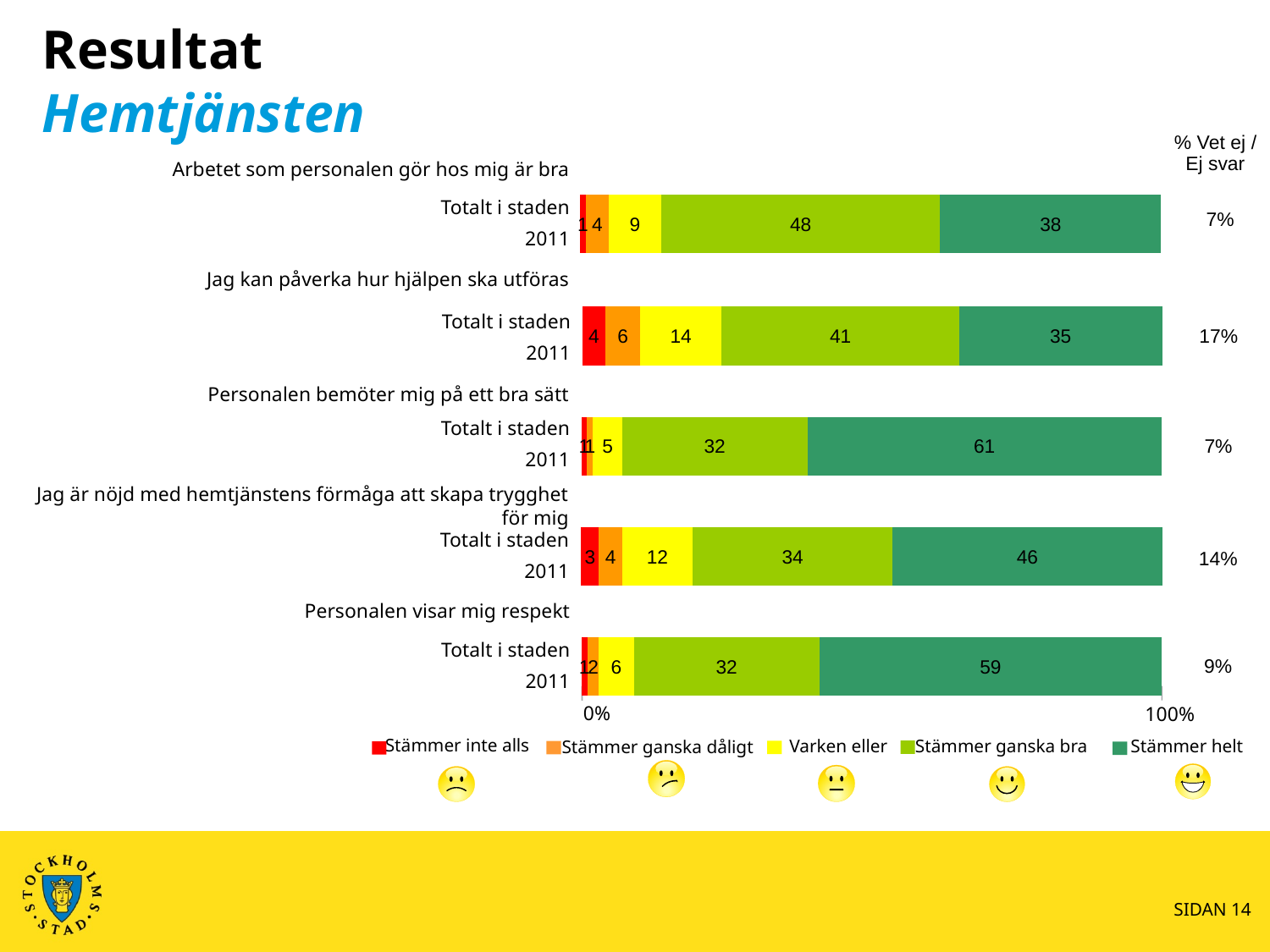
Which legend entry is shown in dark green? Stämmer helt Which statement has the highest "Stämmer helt" value? Personalen bemöter mig på ett bra sätt What is the "Stämmer ganska bra" value for "Arbetet som personalen gör hos mig är bra"? 48 How many series does the legend list? 5 Which is larger: the "Stämmer ganska bra" value for "Arbetet som personalen gör hos mig är bra" or for "Jag kan påverka hur hjälpen ska utföras"? Arbetet som personalen gör hos mig är bra What percentage answered "Stämmer helt" for "Personalen bemöter mig på ett bra sätt"? 61 Which statement has the lowest "Stämmer helt" value? Jag kan påverka hur hjälpen ska utföras What is the "% Vet ej / Ej svar" share for "Jag kan påverka hur hjälpen ska utföras"? 17% What kind of chart is shown on the slide? Stacked bar chart What is the "Varken eller" value for "Jag kan påverka hur hjälpen ska utföras"? 14 How many statements are shown in the chart? 5 What is the difference between the "Stämmer helt" values for "Personalen visar mig respekt" and "Jag är nöjd med hemtjänstens förmåga att skapa trygghet för mig"? 13